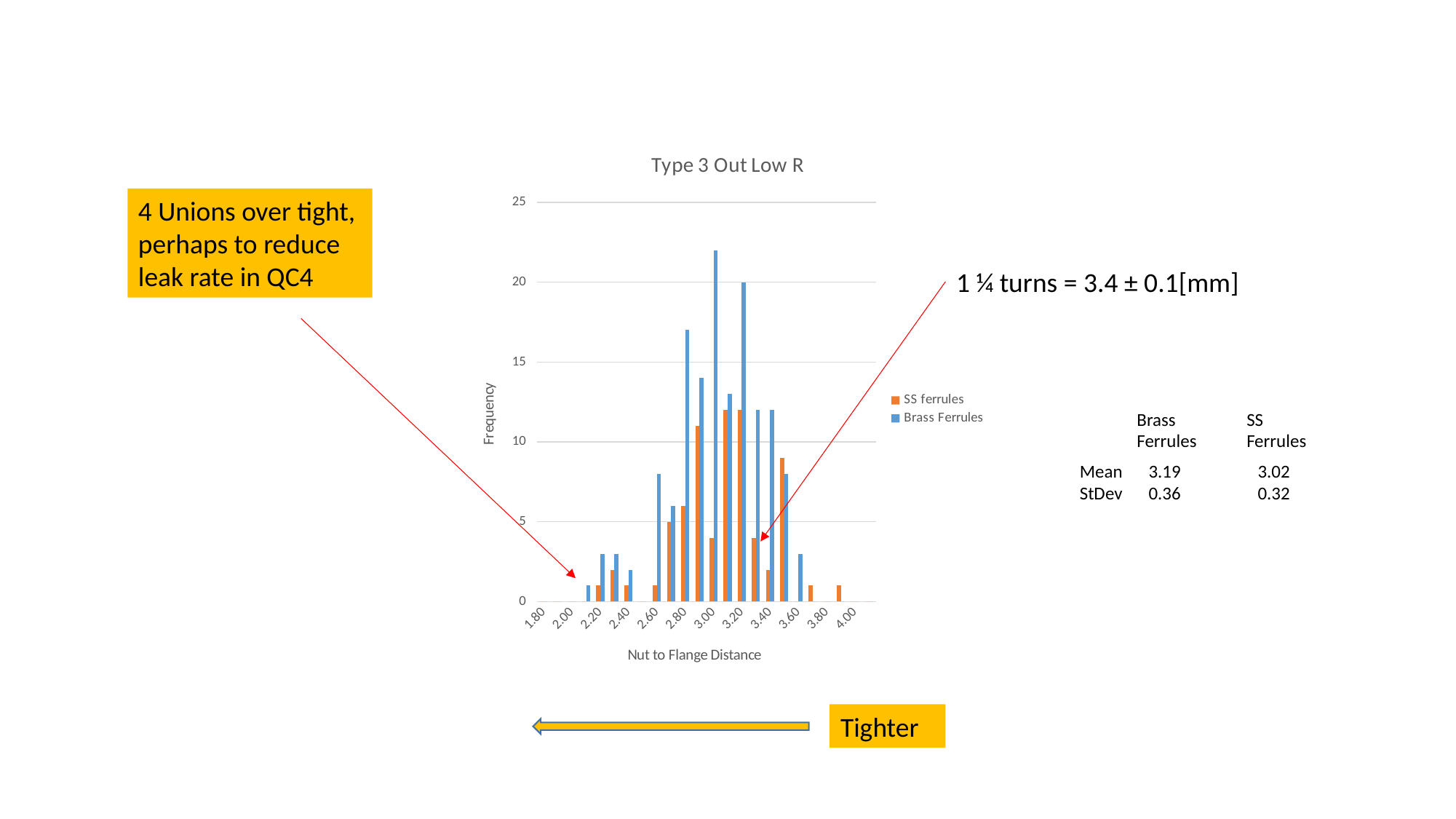
How many series does the legend of the chart list? 2 Which series reaches a higher frequency, SS ferrules or Brass Ferrules? Brass Ferrules Is the tallest SS ferrules bar greater or less than 15? less How many tick labels are shown on the x axis of the chart? 12 Is the SS ferrules bar at 4.00 greater or less than 5? less What is the title of the chart? Type 3 Out Low R What kind of chart is shown on the slide? bar chart Which series has the tallest bar in the chart? Brass Ferrules Is the tallest Brass Ferrules bar greater or less than 20? greater What are the two series named in the chart legend? SS ferrules and Brass Ferrules